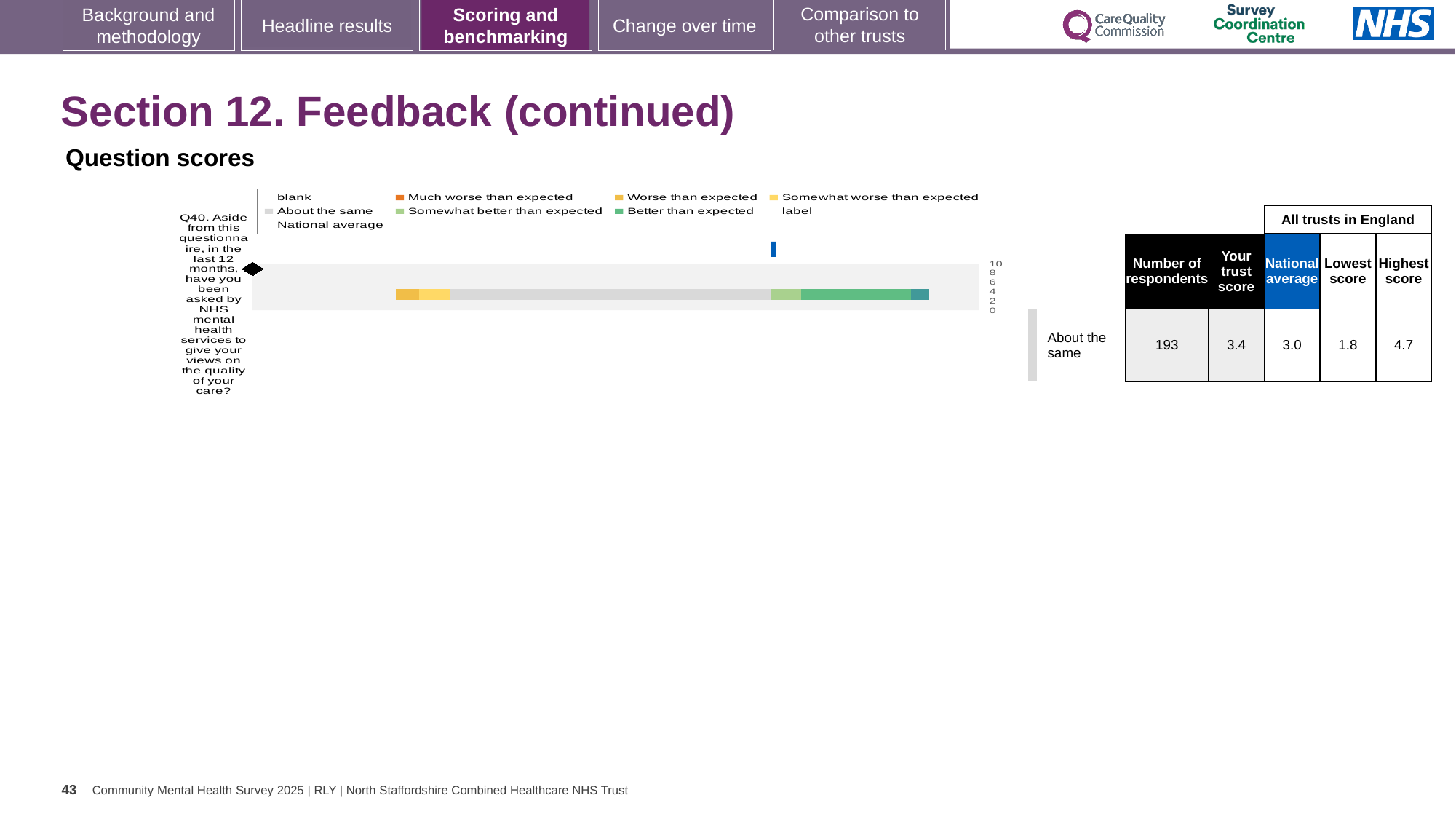
Which question number is plotted in the Question scores chart? Q40 How many questions are plotted in the Question scores chart? 1 What is the highest score among all trusts in England for Q40? 4.7 What is the national average score for Q40? 3.0 By how much does the trust's score for Q40 exceed the national average? 0.4 Which is larger for Q40, the trust's score or the national average? the trust's score What is the trust's score for Q40? 3.4 How many respondents answered Q40? 193 Which benchmark category is the trust's Q40 score placed in? About the same What is the lowest score among all trusts in England for Q40? 1.8 What is the difference between the highest and lowest scores for Q40 across all trusts in England? 2.9 What kind of chart is used to show the Q40 question score? bar chart